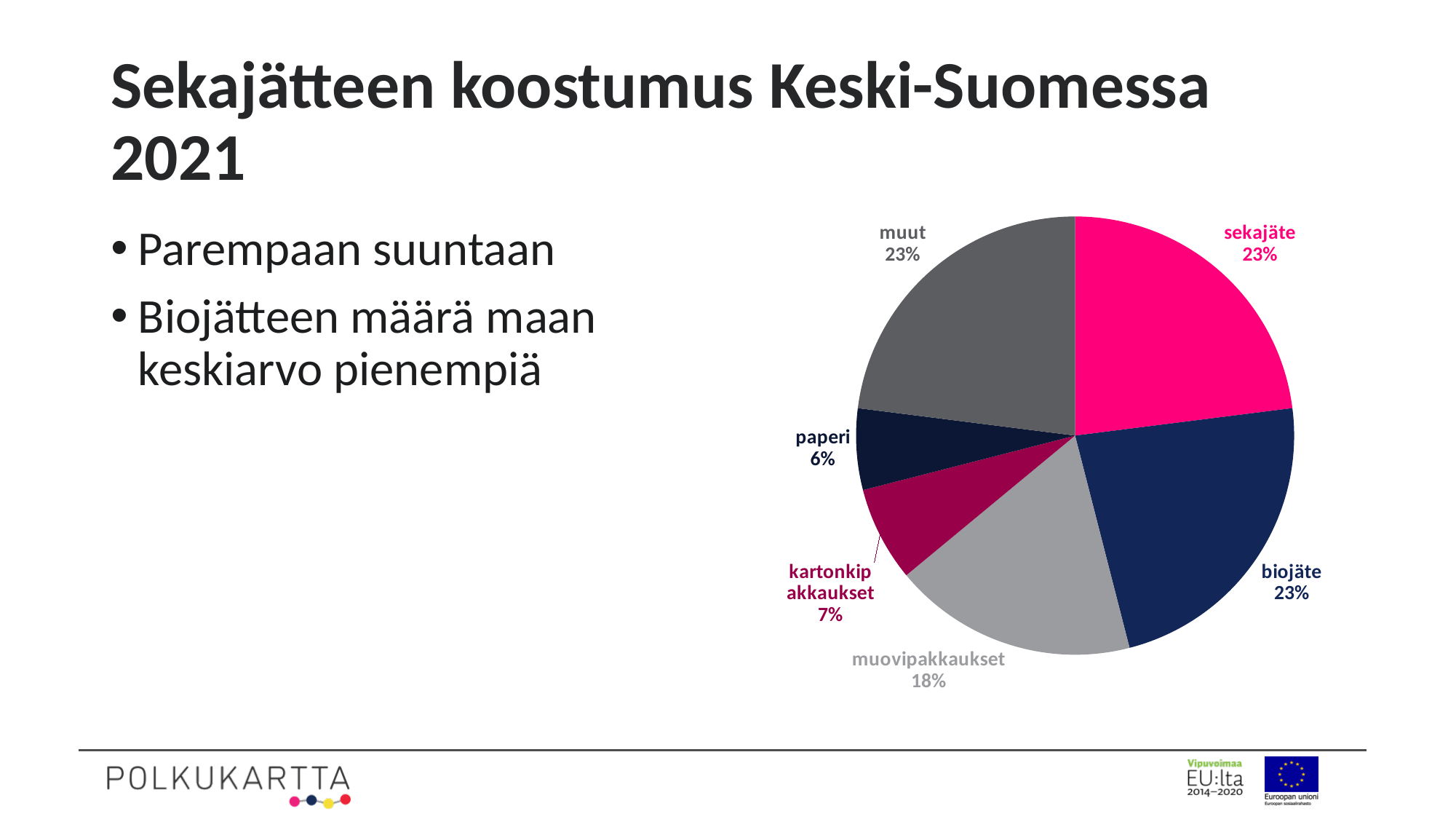
What is the difference in percentage points between kartonkipakkaukset and paperi? 1 What is the difference in percentage points between sekajäte and muovipakkaukset? 5 What percentage is shown for kartonkipakkaukset? 7% What colour is the sekajäte slice? pink What percentage is shown for paperi? 6% What kind of chart is shown on the slide? pie chart Which category has the smallest slice of the pie? paperi What percentage is shown for biojäte? 23% How many slices does the pie chart have? 6 What percentage is shown for muut? 23% Which is larger, the share for muovipakkaukset or the share for paperi? muovipakkaukset What share of the pie does muovipakkaukset have? 18%